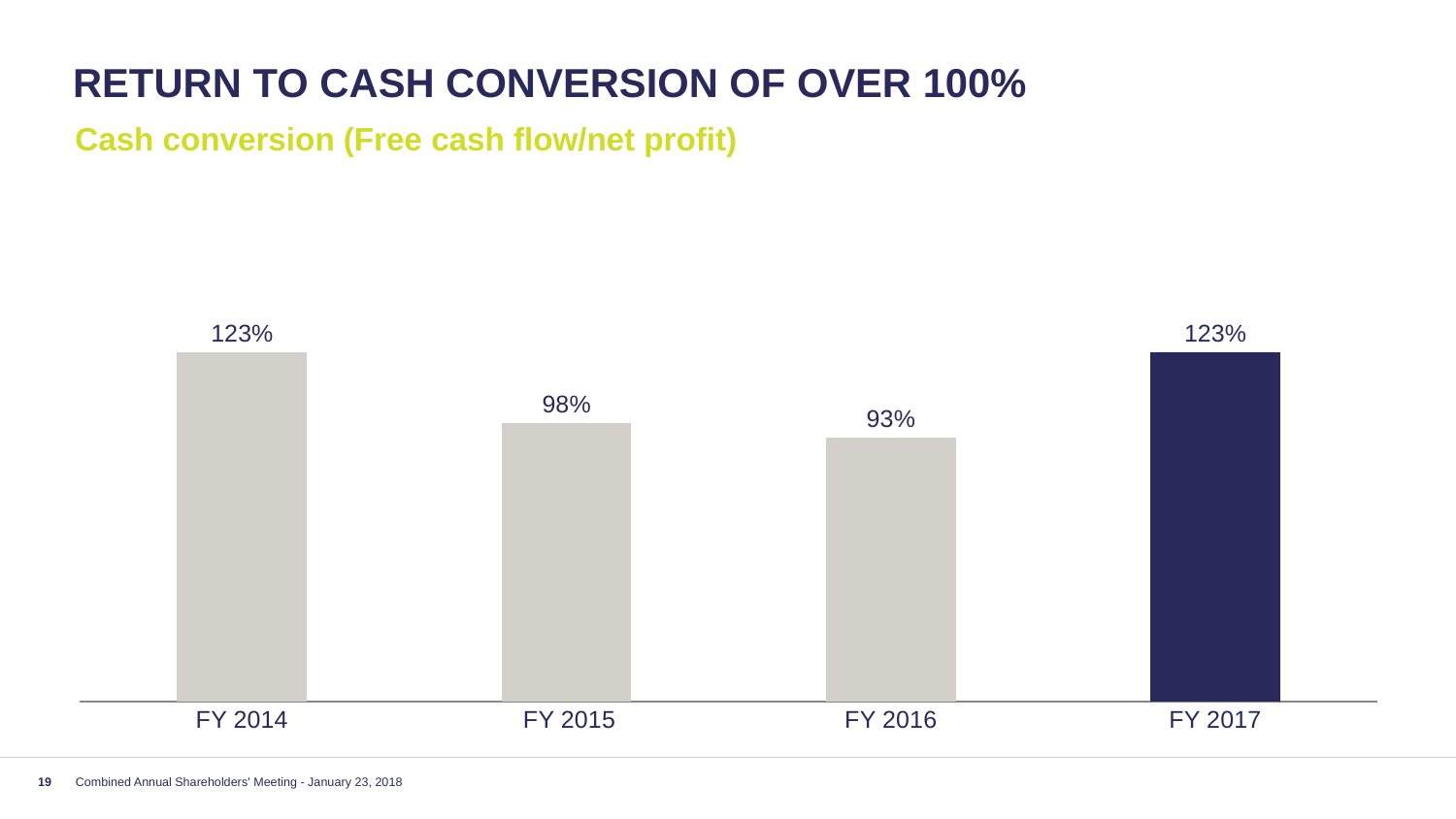
Which is larger, the cash conversion for FY 2015 or for FY 2016? FY 2015 How many fiscal years are shown in the chart? 4 What type of chart is shown on the slide? Bar chart What is the cash conversion value for FY 2016? 93% Which fiscal year has the lowest cash conversion? FY 2016 What is the cash conversion value for FY 2014? 123% What is the difference in cash conversion between FY 2015 and FY 2016? 5% Which fiscal year's bar is shown in a different colour (dark navy) from the others? FY 2017 What is the difference in cash conversion between FY 2017 and FY 2016? 30% What is the cash conversion value for FY 2017? 123% Does the cash conversion rise or fall from FY 2016 to FY 2017? Rise What is the cash conversion value for FY 2015? 98%